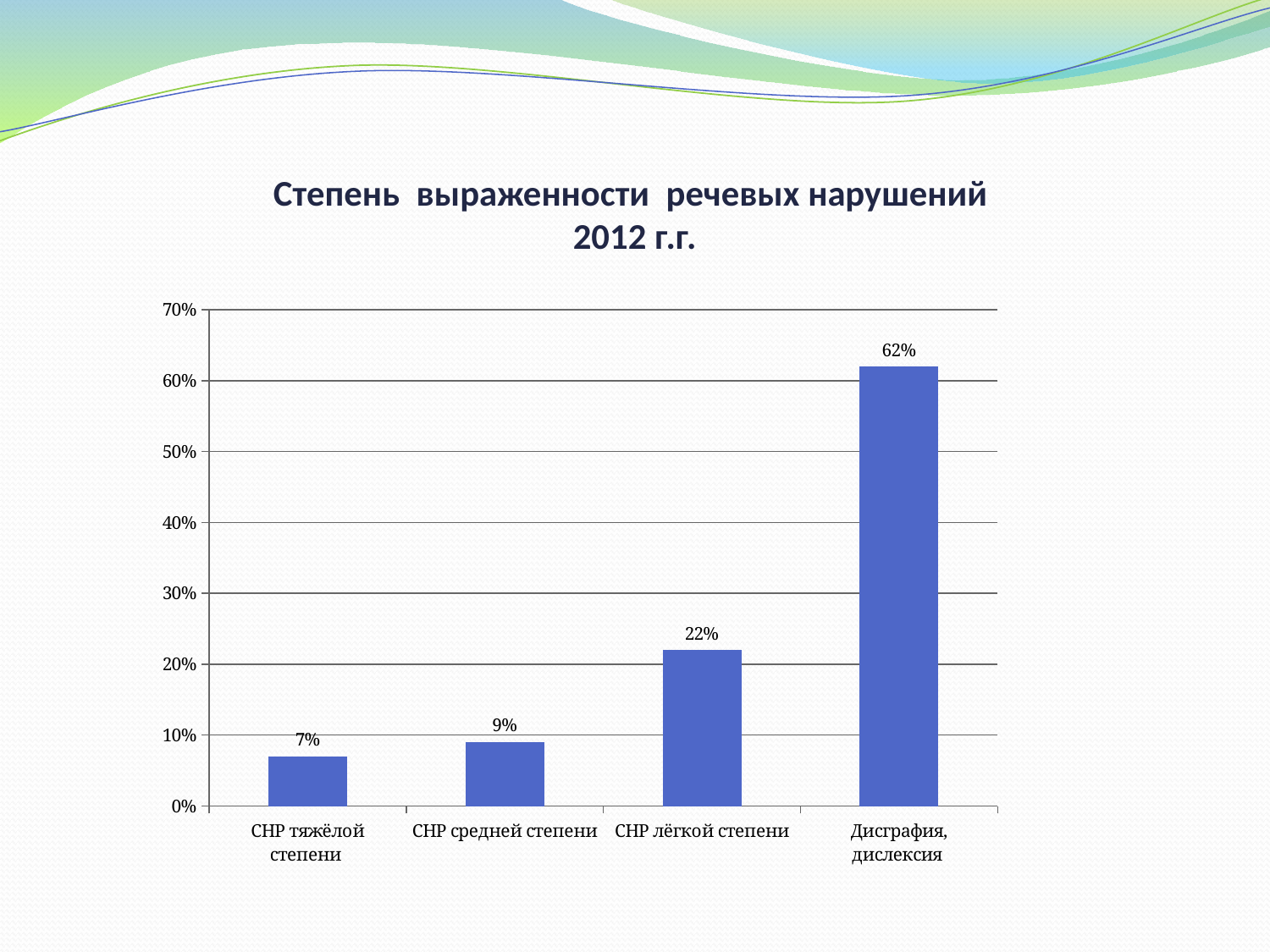
How many categories are shown on the x axis? 4 Which category has the highest value? Дисграфия, дислексия What is the value for СНР лёгкой степени? 22% What kind of chart is shown on the slide? bar chart Which category has the lowest value? СНР тяжёлой степени Do the values rise or fall from left to right along the x axis? rise Which is larger, the value for СНР средней степени or the value for СНР тяжёлой степени? СНР средней степени Is the value for СНР лёгкой степени greater or less than 20%? greater What is the value for СНР средней степени? 9% What is the difference between the values for Дисграфия, дислексия and СНР лёгкой степени? 40% What is the value for СНР тяжёлой степени? 7% What is the value for Дисграфия, дислексия? 62%